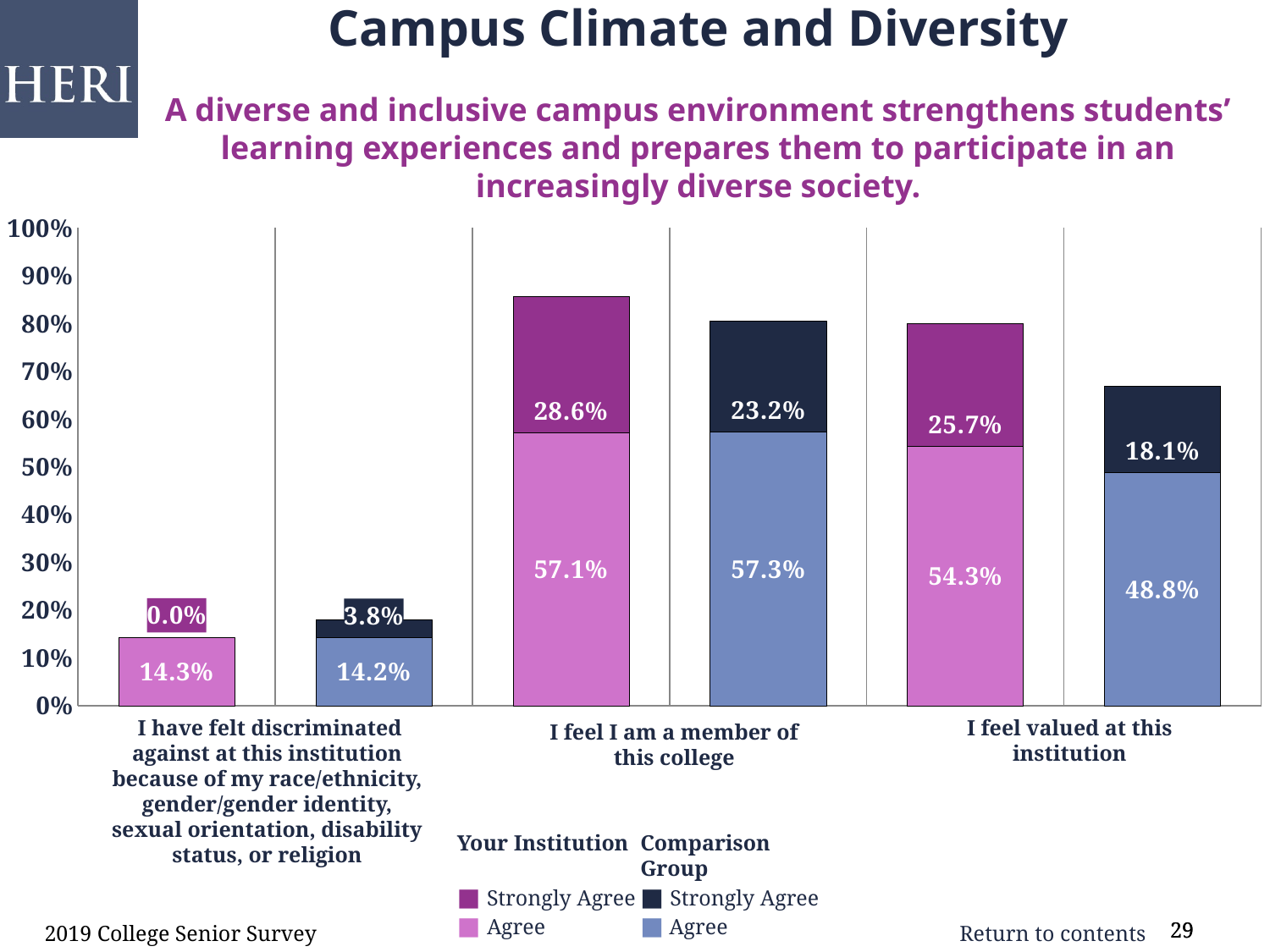
What percentage of students at Your Institution strongly agree that they feel they are a member of this college? 28.6% What is the difference between the Strongly Agree percentages for Your Institution and the Comparison Group on 'I feel valued at this institution'? 7.6% What is the total percentage of Comparison Group students who agree or strongly agree that they feel they are a member of this college? 80.5% What type of chart is shown on the slide? Stacked bar chart How many entries does the chart legend list? 4 What percentage of students at Your Institution strongly agree that they have felt discriminated against at this institution? 0.0% How many statements (categories) are shown on the x axis of the chart? 3 Is the total stacked bar for the Comparison Group on 'I feel valued at this institution' greater or less than 70%? less Which group has a higher Strongly Agree percentage for 'I feel I am a member of this college', Your Institution or the Comparison Group? Your Institution What is the total percentage of Your Institution students who agree or strongly agree that they feel valued at this institution? 80.0% Which statement has the lowest combined agree and strongly agree percentage for Your Institution? I have felt discriminated against at this institution because of my race/ethnicity, gender/gender identity, sexual orientation, disability status, or religion What percentage of the Comparison Group agree that they feel valued at this institution? 48.8%